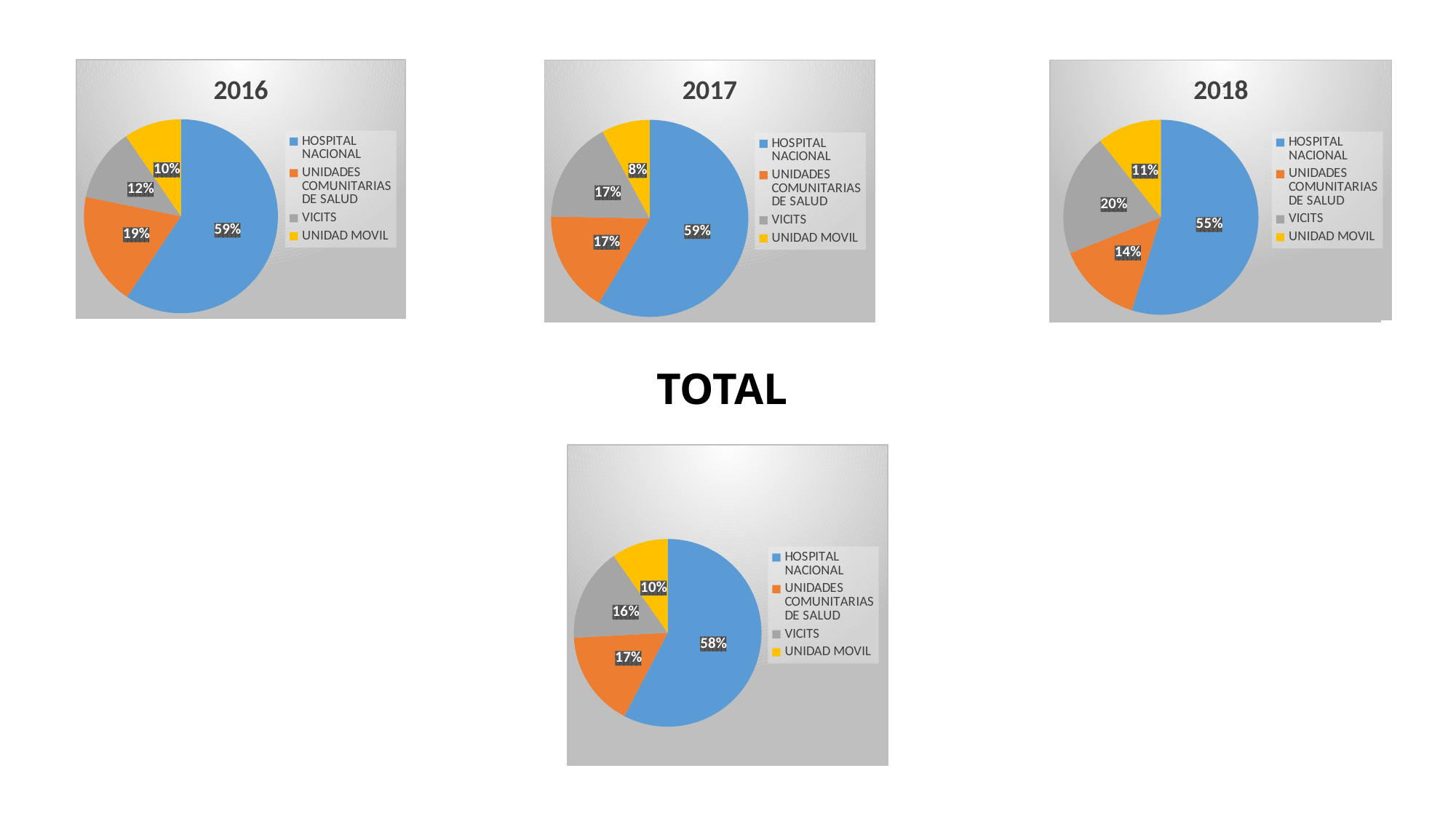
In the 2018 chart, which category has the largest share? HOSPITAL NACIONAL How many categories does the legend of the TOTAL chart list? 4 In the TOTAL chart, which colour represents UNIDAD MOVIL? Yellow In the 2016 chart, which category has the smallest share? UNIDAD MOVIL In the TOTAL chart, what share does UNIDADES COMUNITARIAS DE SALUD have? 17% In the 2018 chart, what share does VICITS have? 20% In the 2016 chart, what is the difference between the shares of UNIDADES COMUNITARIAS DE SALUD and VICITS? 7% How many pie charts are shown on the slide? 4 In the 2016 chart, what share does HOSPITAL NACIONAL have? 59% In the 2017 chart, what share does UNIDAD MOVIL have? 8% What kind of chart is the 2017 chart? Pie chart In the 2018 chart, which is larger: the share of VICITS or the share of UNIDADES COMUNITARIAS DE SALUD? VICITS